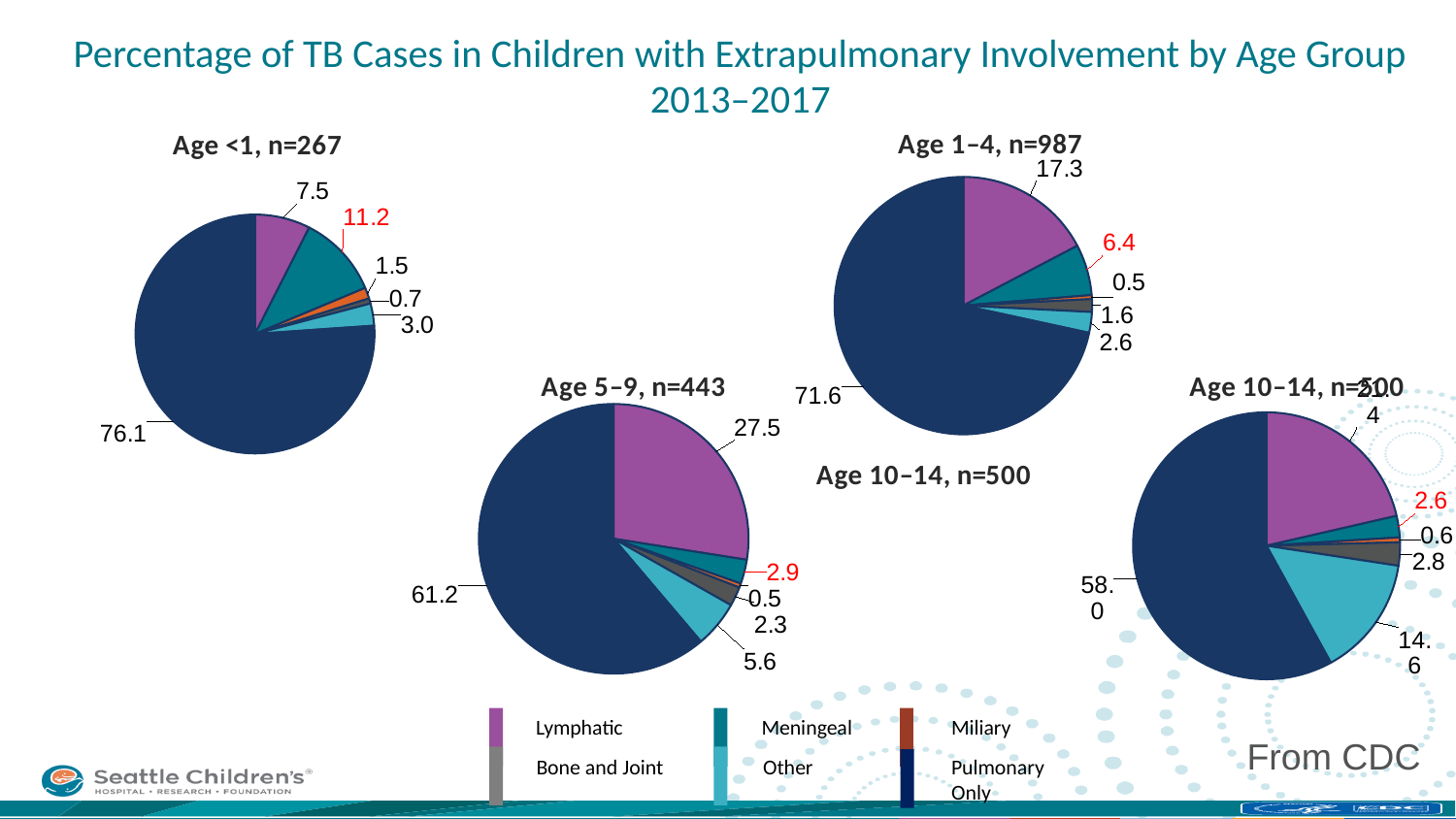
In the Age 5–9, n=443 pie chart, which slice is the smallest? Miliary In the Age 10–14, n=500 pie chart, what value is shown for the Other slice? 14.6 How many categories does the legend list? 6 In the Age 5–9, n=443 pie chart, what value is shown for the Lymphatic slice? 27.5 In the Age <1, n=267 pie chart, what percentage is labelled for the Pulmonary Only slice? 76.1 In the Age 1–4, n=987 pie chart, what value is shown for the Lymphatic slice? 17.3 Which is larger: the Lymphatic slice in the Age 5–9 chart or the Lymphatic slice in the Age 1–4 chart? Age 5–9 In the Age 5–9, n=443 pie chart, which slice is the largest? Pulmonary Only What kind of chart is used for each age group on this slide? pie chart In the Age 1–4, n=987 pie chart, what value is shown for the Pulmonary Only slice? 71.6 In the Age <1, n=267 pie chart, what value is shown for the Meningeal slice? 11.2 How many pie charts are shown on the slide? 4